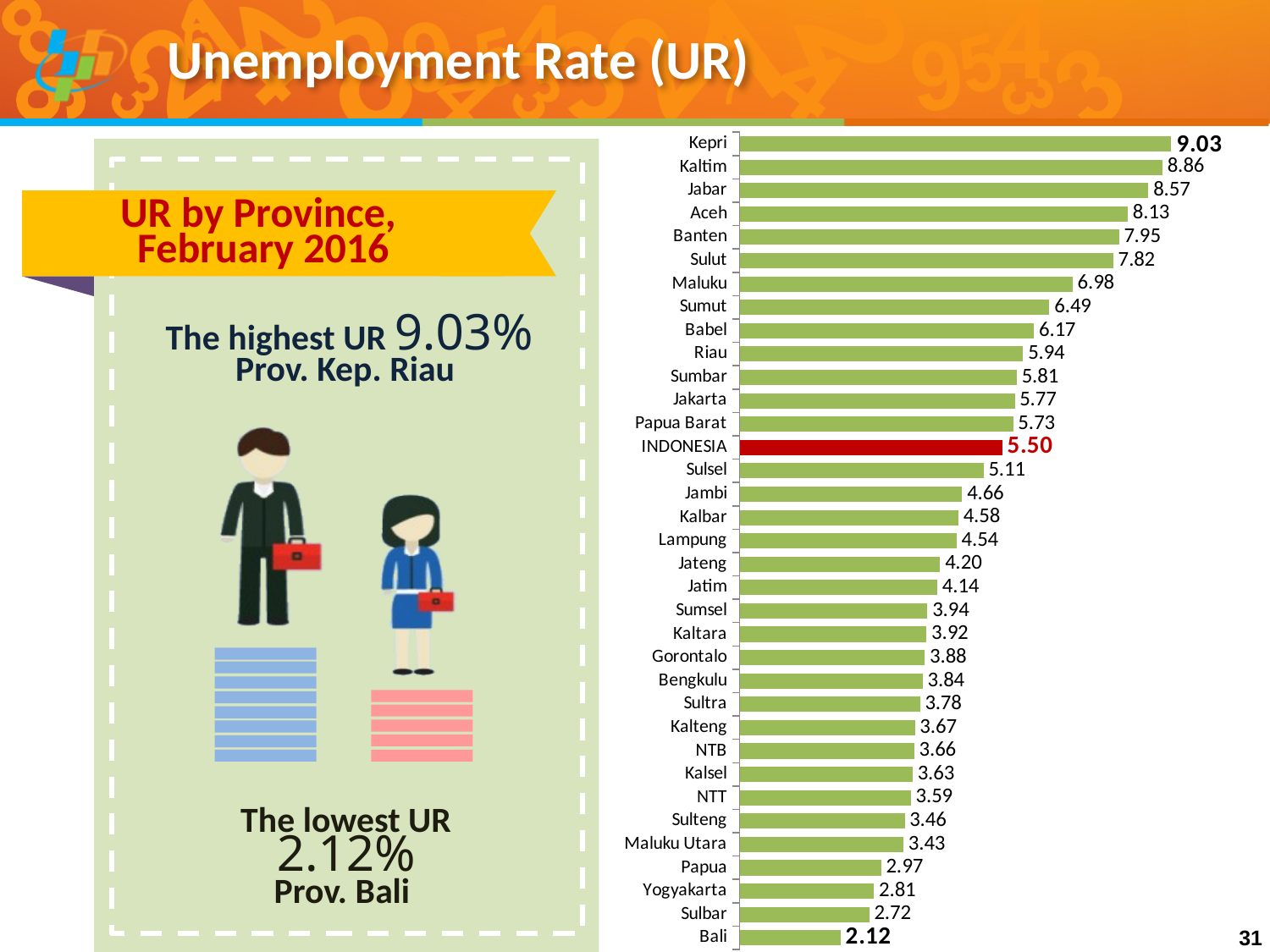
What is the unemployment rate shown for INDONESIA? 5.50 Which bar in the chart is coloured red rather than green? INDONESIA How many bars are plotted in the chart? 35 Which has a higher unemployment rate, Aceh or Sumut? Aceh What is the unemployment rate shown for Kepri? 9.03 What is the unemployment rate shown for Maluku Utara? 3.43 Which province has the lowest unemployment rate in the chart? Bali Which province has the highest unemployment rate in the chart? Kepri What is the difference between the unemployment rates of Jabar and INDONESIA? 3.07 What is the difference between the unemployment rates of Kepri and Bali? 6.91 What is the unemployment rate shown for Jateng? 4.20 What type of chart is used to show the unemployment rate by province? Bar chart